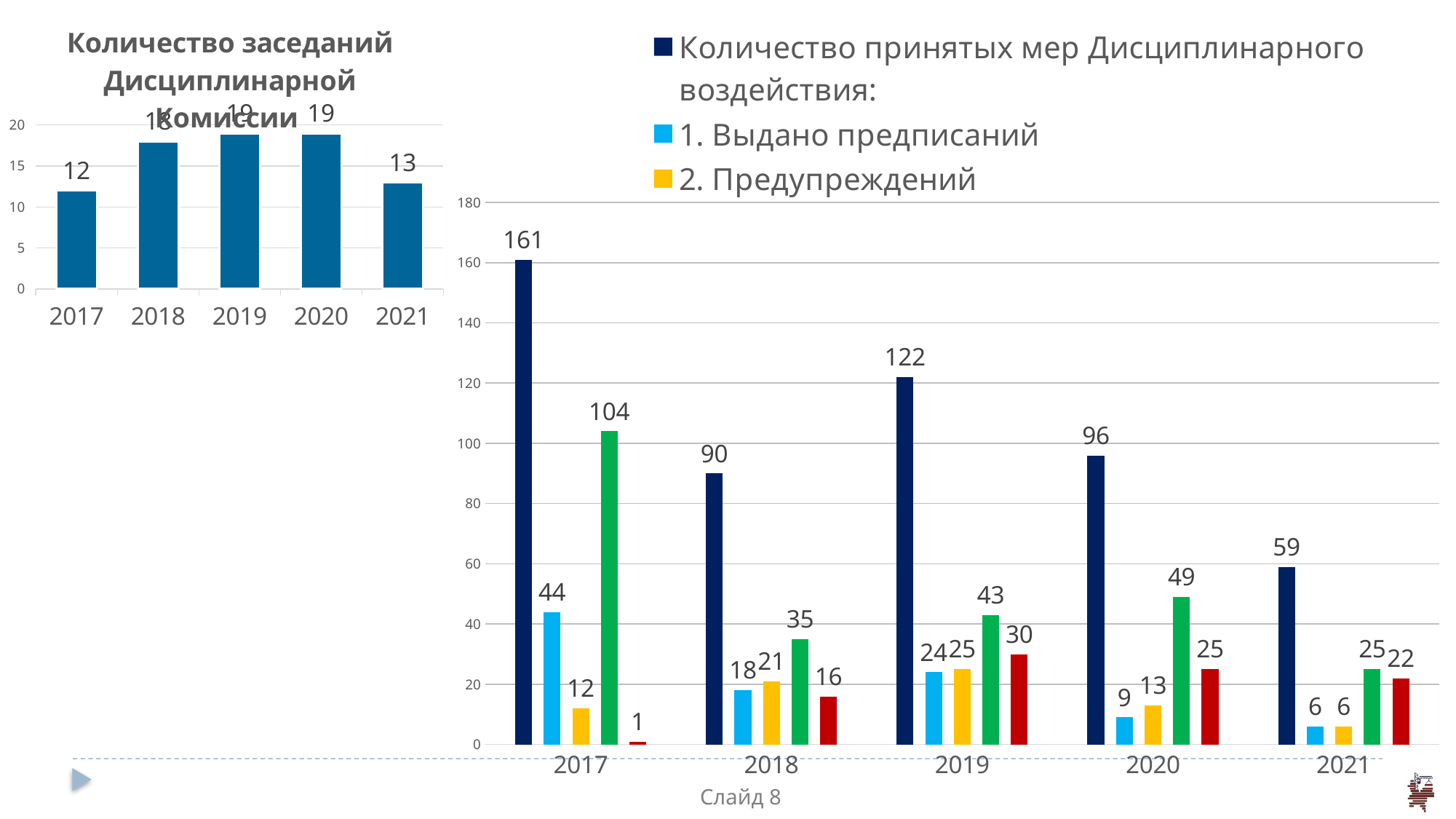
In the left chart (Количество заседаний Дисциплинарной Комиссии), which year has the lowest value? 2017 What type of chart is the right chart? Bar chart In the left chart (Количество заседаний Дисциплинарной Комиссии), what is the value for 2017? 12 In the right chart, in which year is 'Количество принятых мер Дисциплинарного воздействия' the lowest? 2021 In the right chart, what is the value of '1. Выдано предписаний' for 2019? 24 In the left chart (Количество заседаний Дисциплинарной Комиссии), what is the value for 2021? 13 In the right chart, what is the value of '2. Предупреждений' for 2020? 13 In the right chart, what is the difference between 'Количество принятых мер Дисциплинарного воздействия' in 2017 and in 2018? 71 In the right chart, what is the value of 'Количество принятых мер Дисциплинарного воздействия' for 2017? 161 In the right chart, which is larger: '1. Выдано предписаний' in 2017 or '2. Предупреждений' in 2017? 1. Выдано предписаний In the right chart, how many series does the legend list? 3 In the left chart (Количество заседаний Дисциплинарной Комиссии), how many years are shown on the x axis? 5